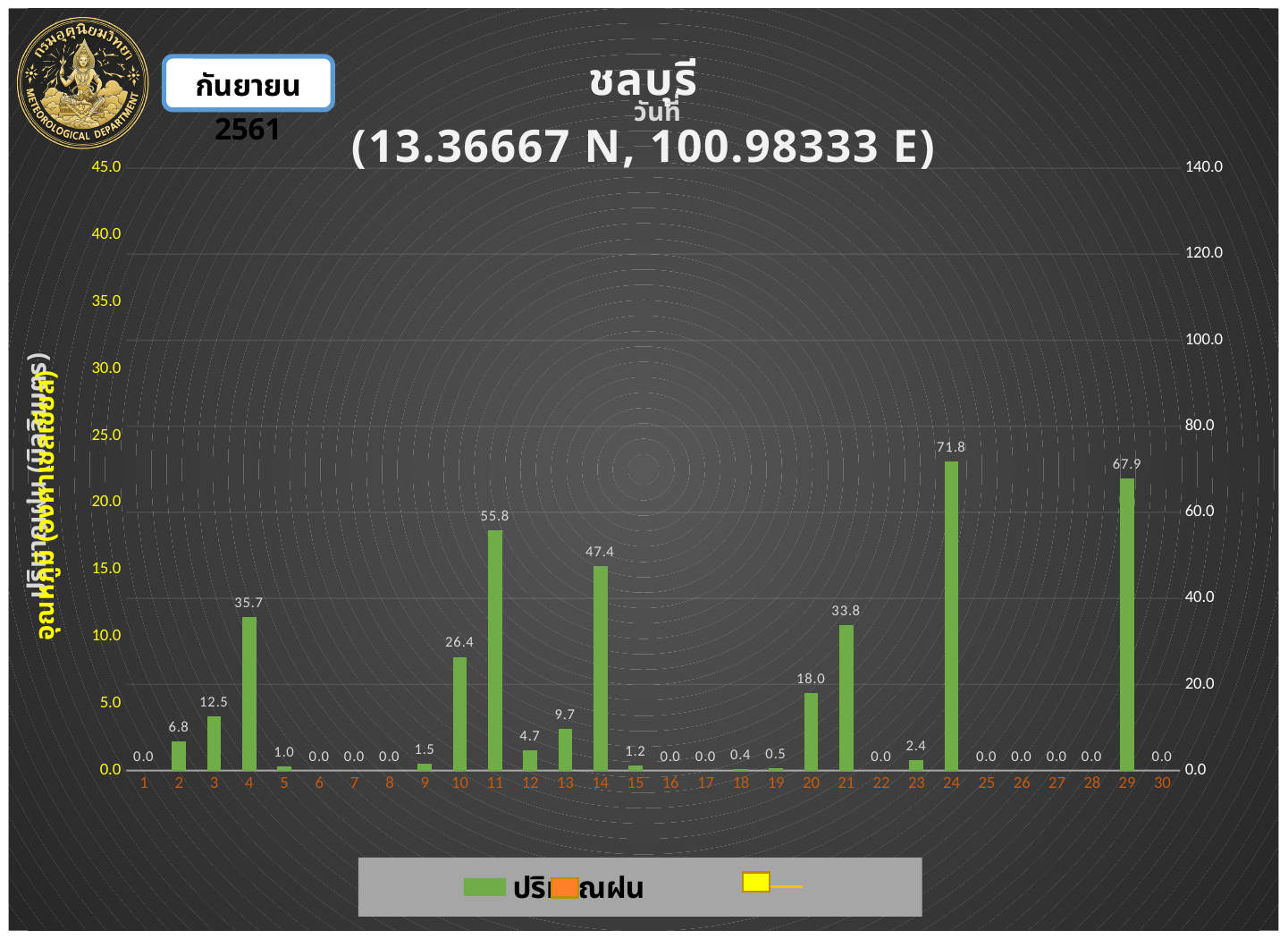
What is the difference between the rainfall values for day 11 and day 14? 8.4 Which is larger, the rainfall value for day 10 or for day 21? day 21 What kind of chart is shown on the slide? bar chart What is the rainfall value shown for day 24? 71.8 What is the difference between the rainfall values for day 24 and day 29? 3.9 What is the rainfall value shown for day 20? 18.0 Which is larger, the rainfall value for day 3 or for day 13? day 3 What colour are the rainfall (ปริมาณฝน) bars? green What is the rainfall value shown for day 11? 55.8 Which day has the highest rainfall value? 24 What is the rainfall value shown for day 4? 35.7 How many days are shown on the x axis? 30